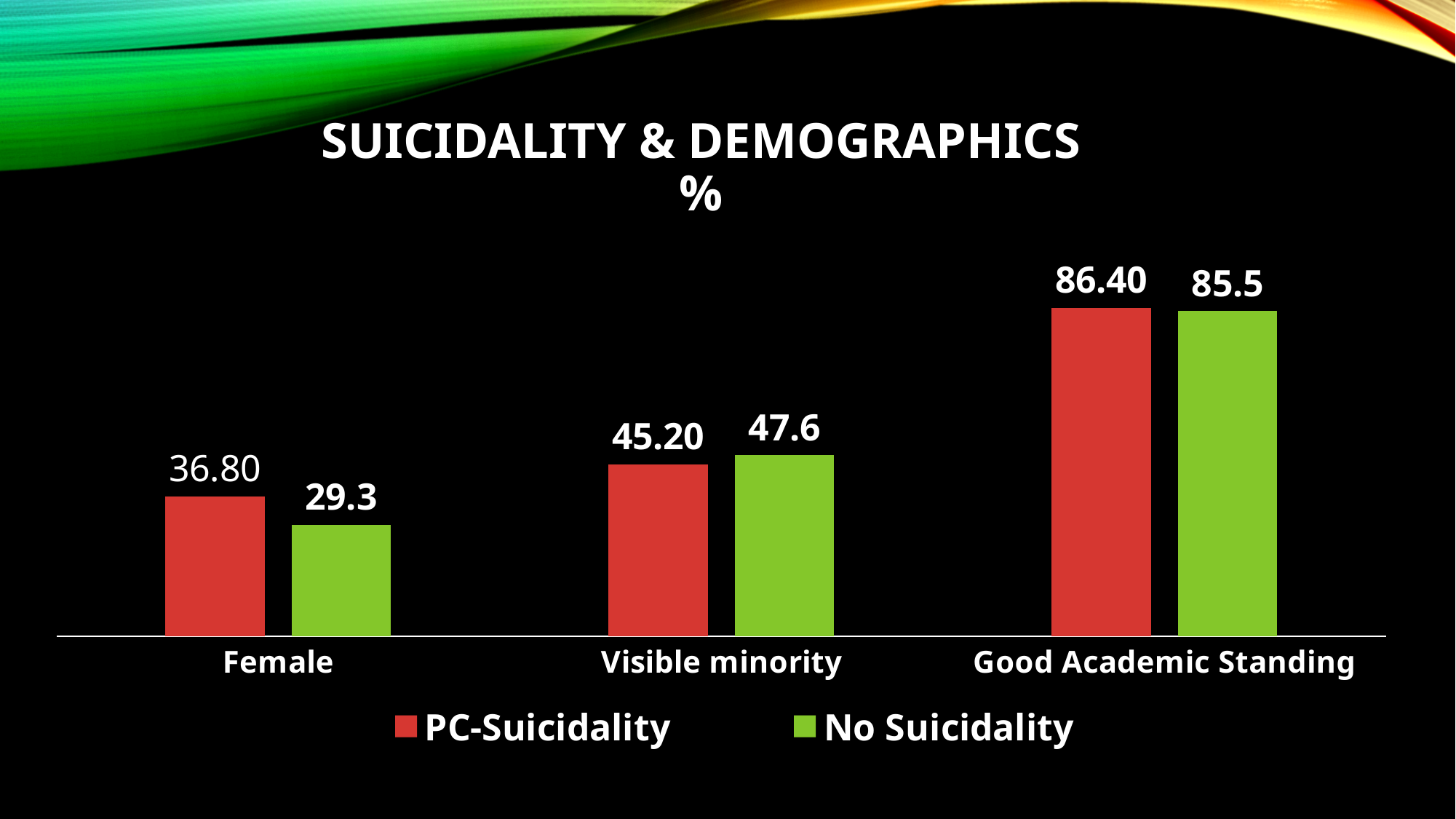
What is the difference between the PC-Suicidality and No Suicidality values for Female? 7.5 For Visible minority, which series has the larger value, PC-Suicidality or No Suicidality? No Suicidality Which category has the highest PC-Suicidality value? Good Academic Standing What kind of chart is shown on the slide? Bar chart How many series does the legend list? 2 What is the PC-Suicidality value for Good Academic Standing? 86.40 How many categories are shown on the x axis? 3 What is the No Suicidality value for Female? 29.3 What is the PC-Suicidality value for Female? 36.80 What is the No Suicidality value for Visible minority? 47.6 What colour are the No Suicidality bars? Green Which category has the lowest No Suicidality value? Female